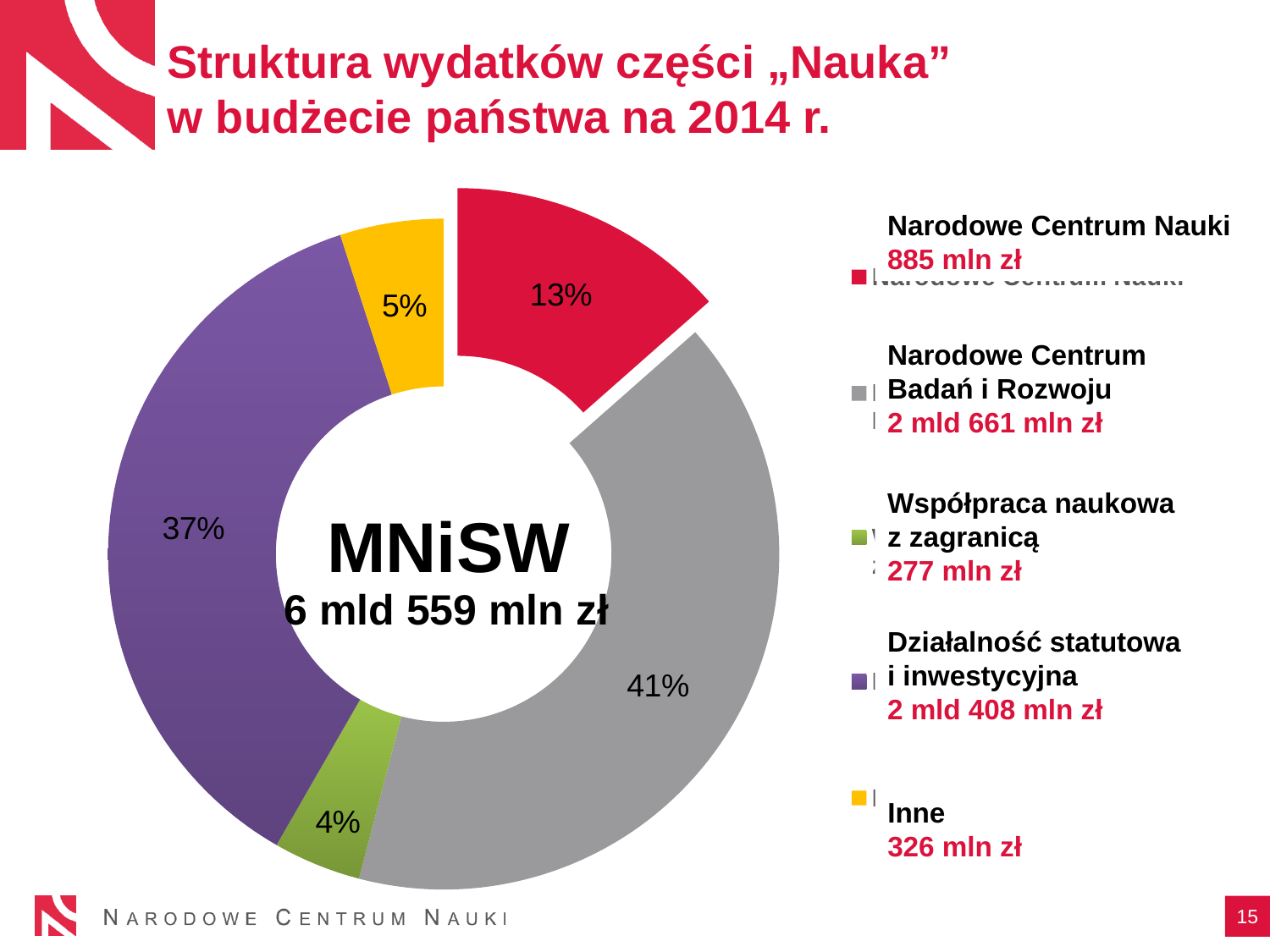
What kind of chart is shown on the slide? doughnut (pie) chart What percentage share does Inne have in the chart? 5% What total amount is shown in the centre of the chart for MNiSW? 6 mld 559 mln zł Which has a larger share: Narodowe Centrum Nauki or Inne? Narodowe Centrum Nauki Which category has the smallest share of the chart? Współpraca naukowa z zagranicą Which category has the largest share of the chart? Narodowe Centrum Badań i Rozwoju What percentage share does Działalność statutowa i inwestycyjna have in the chart? 37% What percentage share does Narodowe Centrum Nauki have in the chart? 13% How many categories (slices) does the chart have? 5 What percentage share does Narodowe Centrum Badań i Rozwoju have in the chart? 41% What is the difference in percentage points between the shares of Narodowe Centrum Badań i Rozwoju and Działalność statutowa i inwestycyjna? 4 percentage points What percentage share does Współpraca naukowa z zagranicą have in the chart? 4%